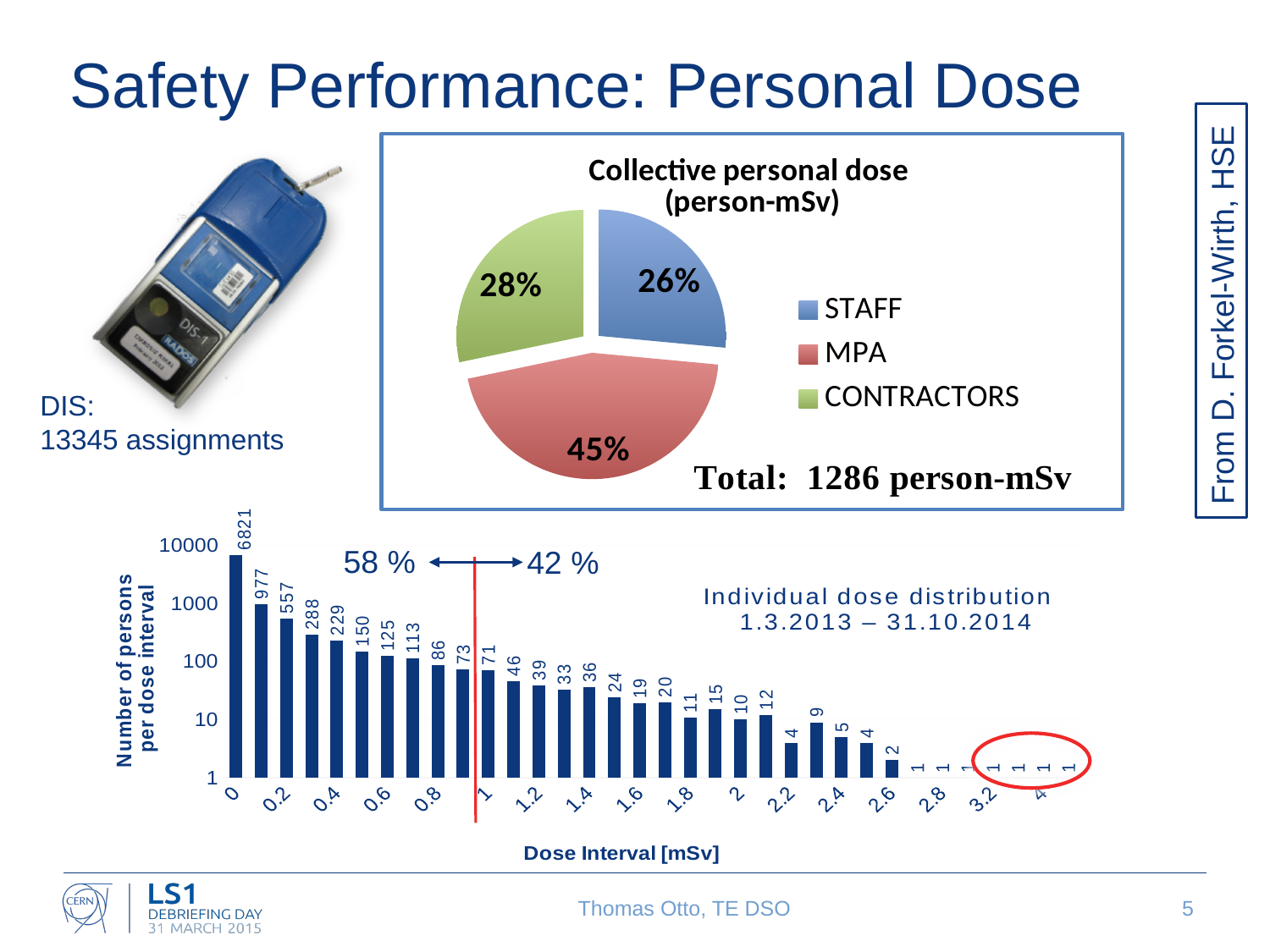
What is the y-axis label of the 'Individual dose distribution' chart? Number of persons per dose interval In the 'Individual dose distribution' chart, how many persons are in the 0 mSv dose interval? 6821 What type of chart is the 'Individual dose distribution' chart at the bottom of the slide? Bar chart In the 'Individual dose distribution' chart, do the number of persons generally rise or fall as the dose interval increases? Fall In the 'Collective personal dose (person-mSv)' chart, how many percentage points larger is the MPA share than the CONTRACTORS share? 17 percentage points In the 'Collective personal dose (person-mSv)' chart, what share of the collective dose is attributed to MPA? 45% How many groups does the legend of the 'Collective personal dose (person-mSv)' chart list? 3 In the 'Collective personal dose (person-mSv)' chart, which group has the smallest share? STAFF In the 'Collective personal dose (person-mSv)' chart, what share of the collective dose is attributed to STAFF? 26% What type of chart is the 'Collective personal dose (person-mSv)' chart? Pie chart What total collective personal dose is stated next to the pie chart? 1286 person-mSv In the 'Collective personal dose (person-mSv)' chart, which group has the largest share? MPA